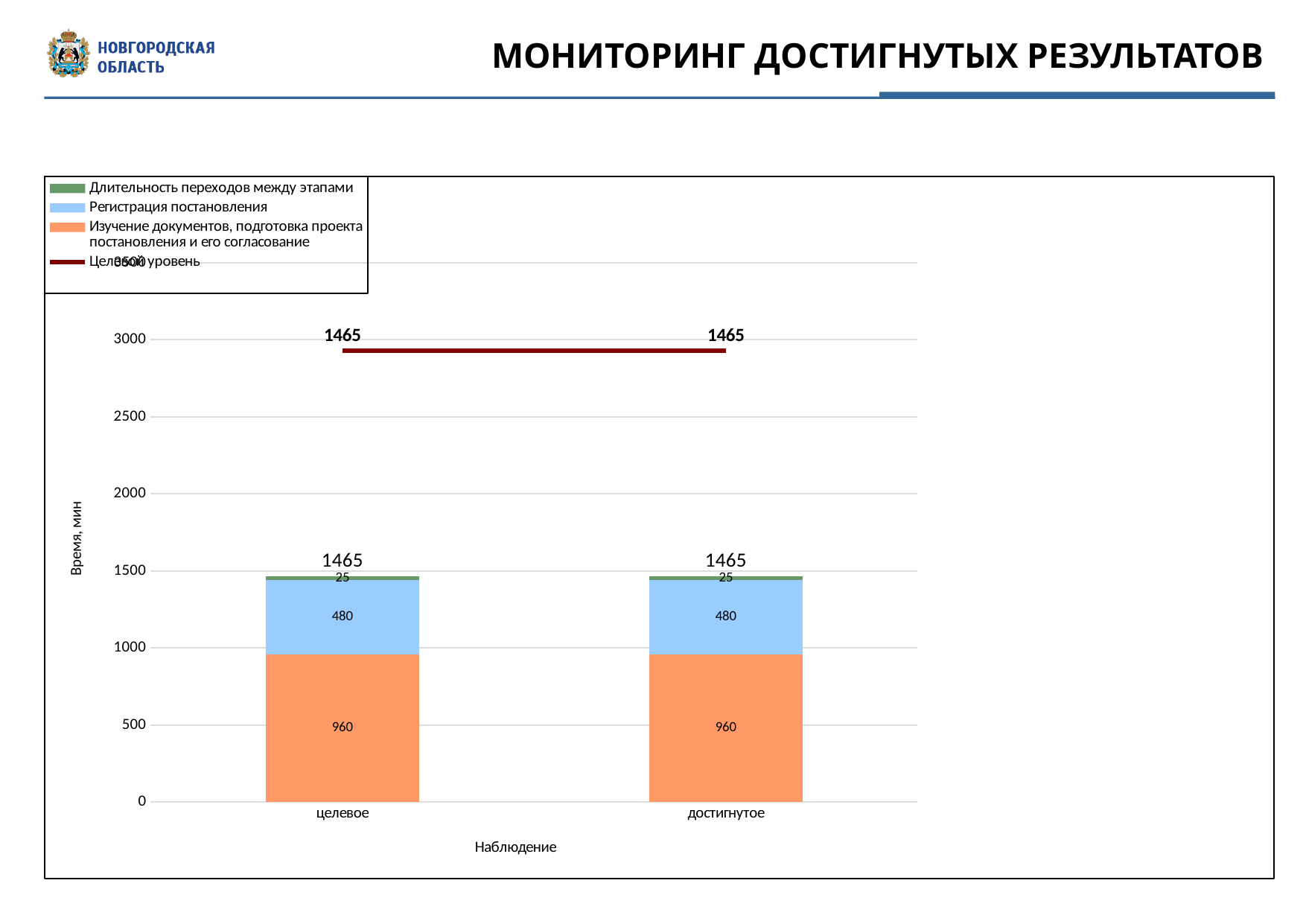
Is the total of the 'целевое' bar greater or less than 1000? greater What is the value of 'Регистрация постановления' for 'достигнутое'? 480 What is the value of 'Длительность переходов между этапами' for 'целевое'? 25 How many series does the chart legend list? 4 What kind of chart is shown on the slide? stacked bar chart with a line (combination bar and line chart) What is the value of 'Изучение документов, подготовка проекта постановления и его согласование' for 'целевое'? 960 What is the difference between 'Изучение документов, подготовка проекта постановления и его согласование' and 'Регистрация постановления' for 'достигнутое'? 480 What is the value of 'Целевой уровень' for 'целевое'? 1465 Which series has the smallest value in the 'целевое' bar? Длительность переходов между этапами What is the label of the y axis of the chart? Время, мин What is the total of the stacked bar for 'достигнутое'? 1465 How many categories are shown on the x axis of the chart? 2